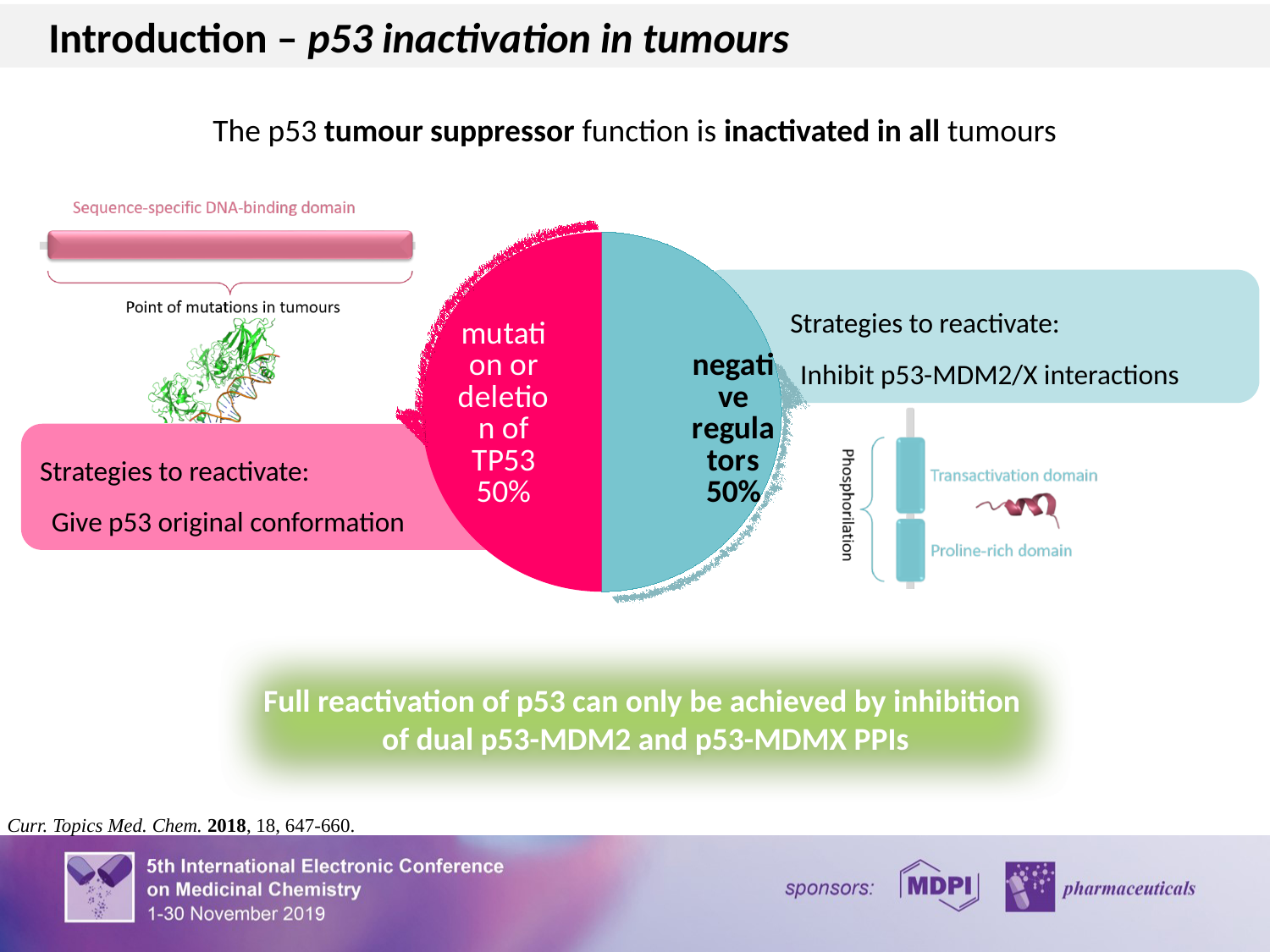
What percentage of tumours does the pie chart attribute to negative regulators? 50% What colour is the "negative regulators" slice of the pie chart? blue What kind of chart is shown on the slide? pie chart What colour is the "mutation or deletion of TP53" slice of the pie chart? pink Are the two slices of the pie chart equal in size? yes How many slices does the pie chart have? 2 What share of the pie chart is labelled "negative regulators"? 50% What share of the pie chart is labelled "mutation or deletion of TP53"? 50% What percentage of tumours does the pie chart attribute to mutation or deletion of TP53? 50%